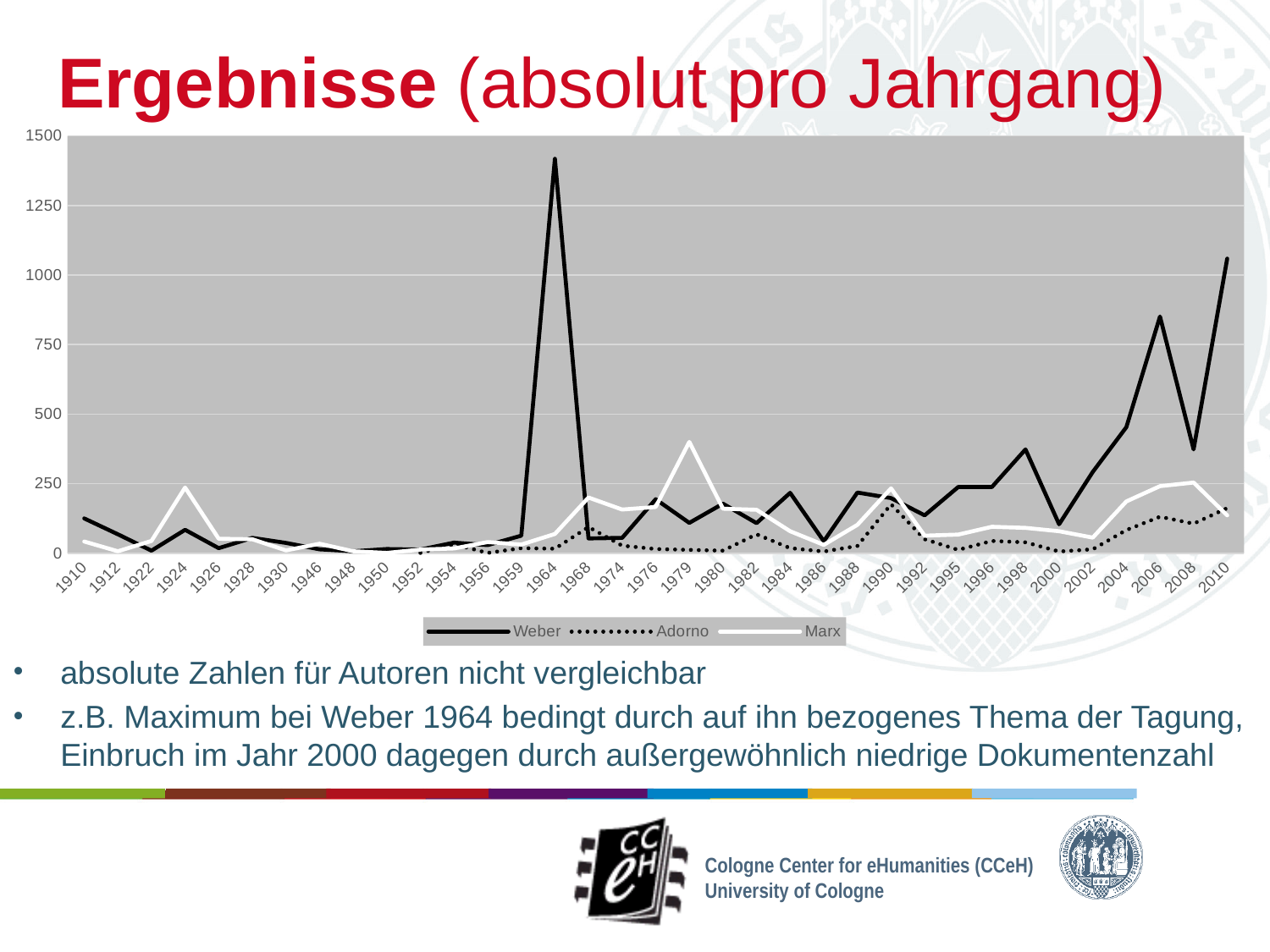
In which year does the Weber series reach its highest value? 1964 Is the value for Marx in 1979 greater or less than 500? less Is the value for Weber in 1964 greater or less than 1250? greater What kind of chart is shown on the slide? line chart Which series are listed in the legend? Weber, Adorno, Marx Which is larger in 2006, the value for Weber or the value for Marx? Weber Which series is drawn with a dotted line? Adorno Is the value for Weber in 2006 greater or less than 750? greater In which year does the Marx series reach its highest value? 1979 How many series does the legend list? 3 How many years are labelled on the x axis? 35